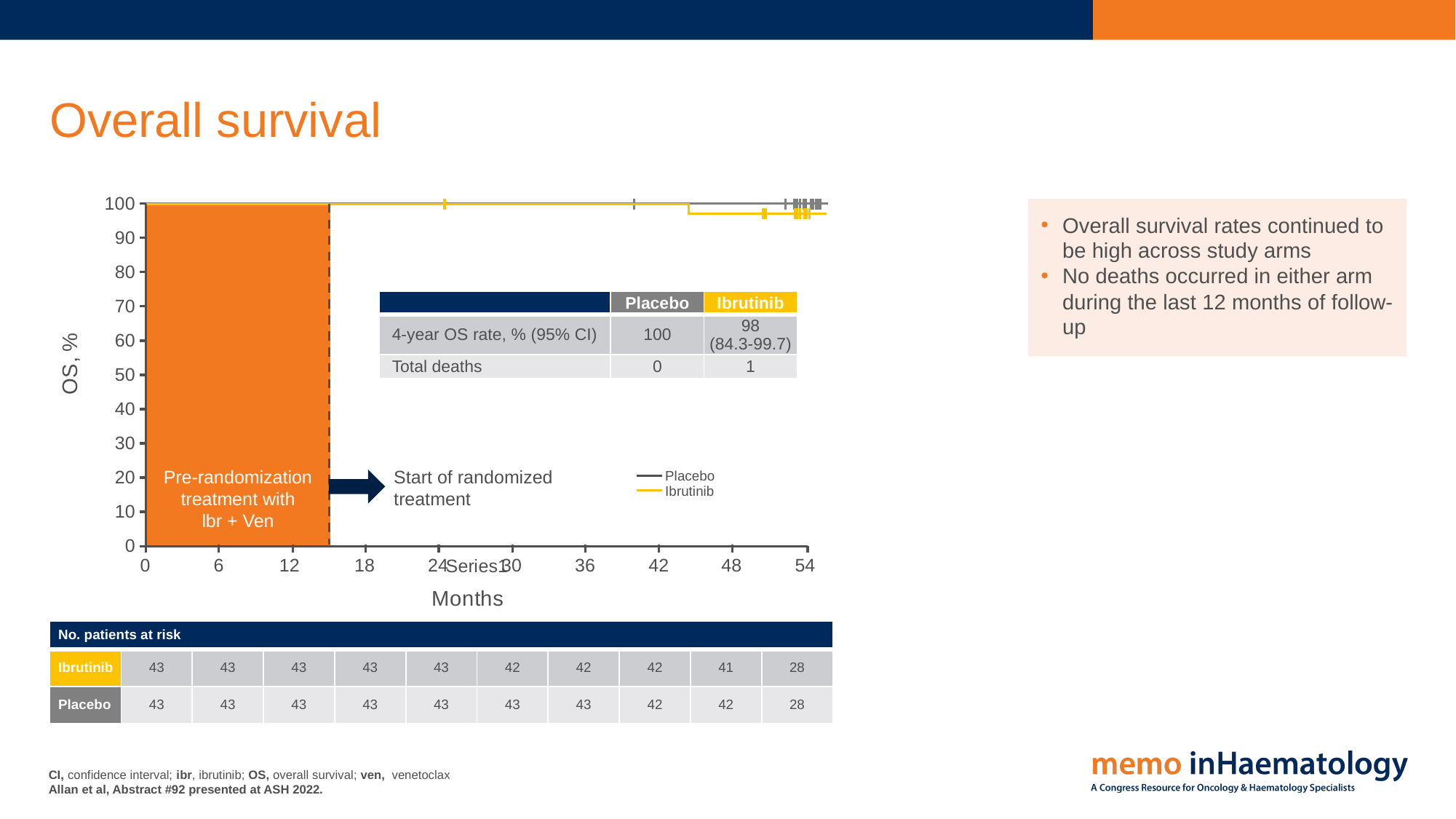
How many series does the chart legend list? 2 Which arm has the higher 4-year OS rate, Placebo or Ibrutinib? Placebo What is the 4-year OS rate (95% CI) for the Ibrutinib arm shown in the chart's table? 98 (84.3-99.7) How many total deaths are reported for the Ibrutinib arm in the chart's table? 1 Is the Ibrutinib survival curve at 54 months greater or less than 90? greater What is the label of the y axis of the chart? OS, % What kind of chart is shown on the slide? Line chart What is the difference in total deaths between the Ibrutinib and Placebo arms? 1 Does the Ibrutinib curve rise or fall as months increase along the x axis? fall What is the 4-year OS rate for the Placebo arm shown in the chart's table? 100 How many Ibrutinib patients are at risk at the last time point in the 'No. patients at risk' table? 28 What are the two series named in the chart legend? Placebo and Ibrutinib